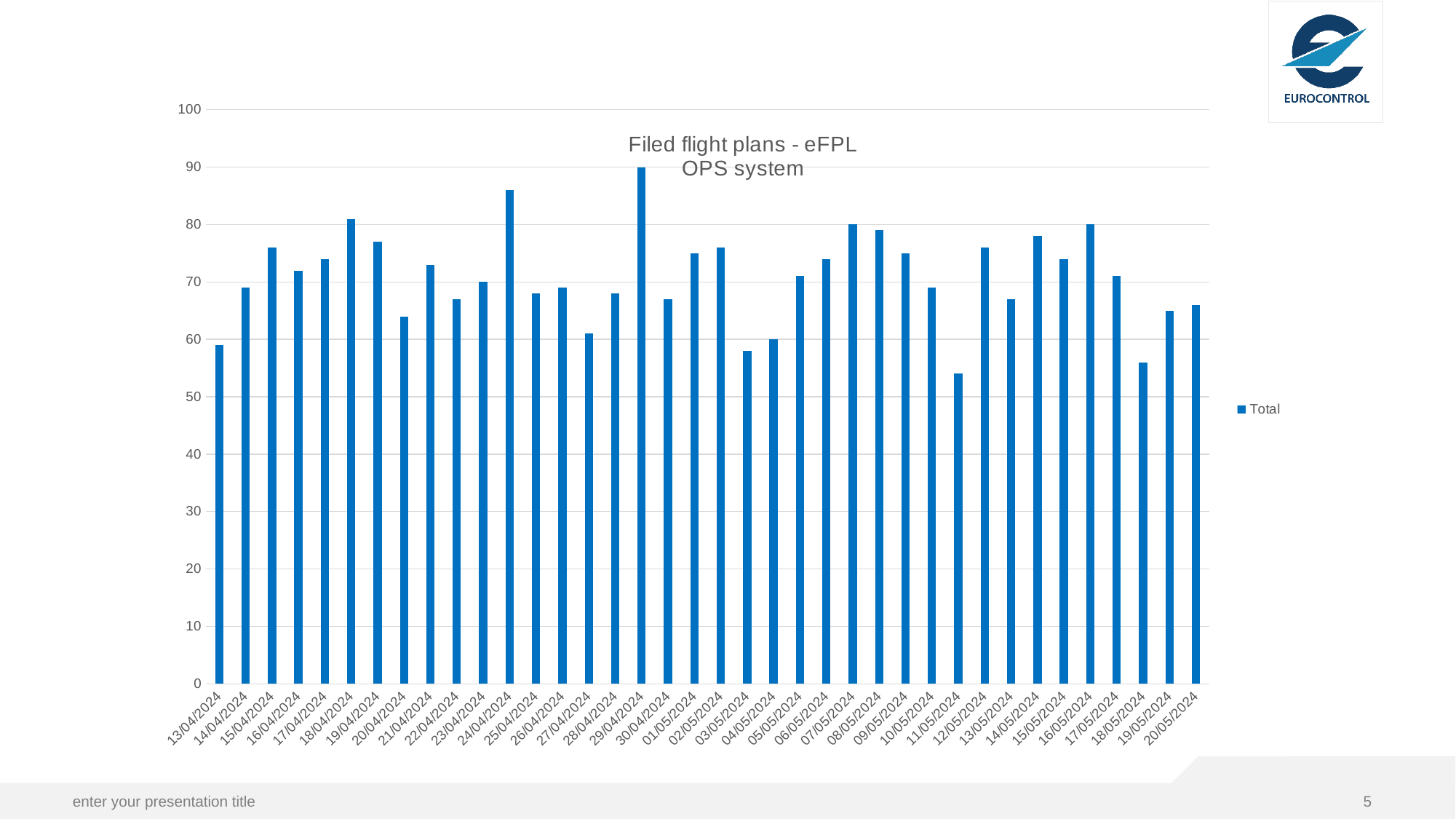
Is the value for 29/04/2024 greater or less than 80? greater What is the title of the chart? Filed flight plans - eFPL OPS system Is the value for 13/04/2024 greater or less than 70? less Which date has the highest value? 29/04/2024 Is the value for 24/04/2024 greater or less than 80? greater What is the name of the series shown in the legend? Total Which is larger, the value for 24/04/2024 or the value for 11/05/2024? 24/04/2024 How many series does the legend list? 1 How many dates are shown on the x axis? 38 What kind of chart is shown on the slide? bar chart Which is larger, the value for 29/04/2024 or the value for 13/04/2024? 29/04/2024